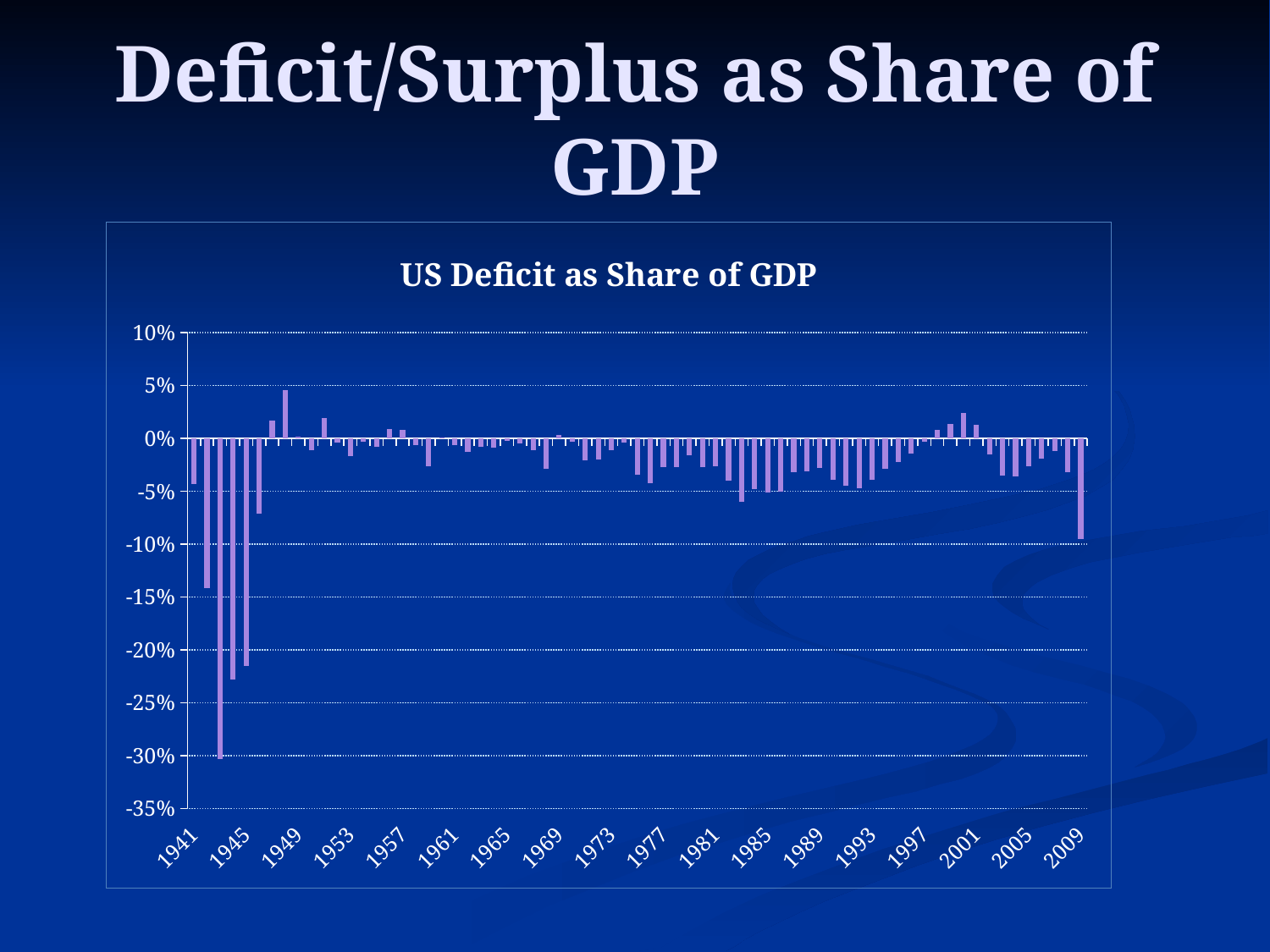
Do the values generally rise or fall from 2001 to 2009? fall Is the value for 1945 greater or less than -15%? less Is the value for 2001 greater or less than 0%? greater What are the lowest and highest values shown on the y axis? -35% and 10% Is the value for 1941 greater or less than 0%? less Which year has the lower value, 1945 or 2009? 1945 What is the title of the chart? US Deficit as Share of GDP What kind of chart is shown on the slide? bar chart How many year labels are shown on the x axis? 18 Which year has the lower value, 2009 or 1985? 2009